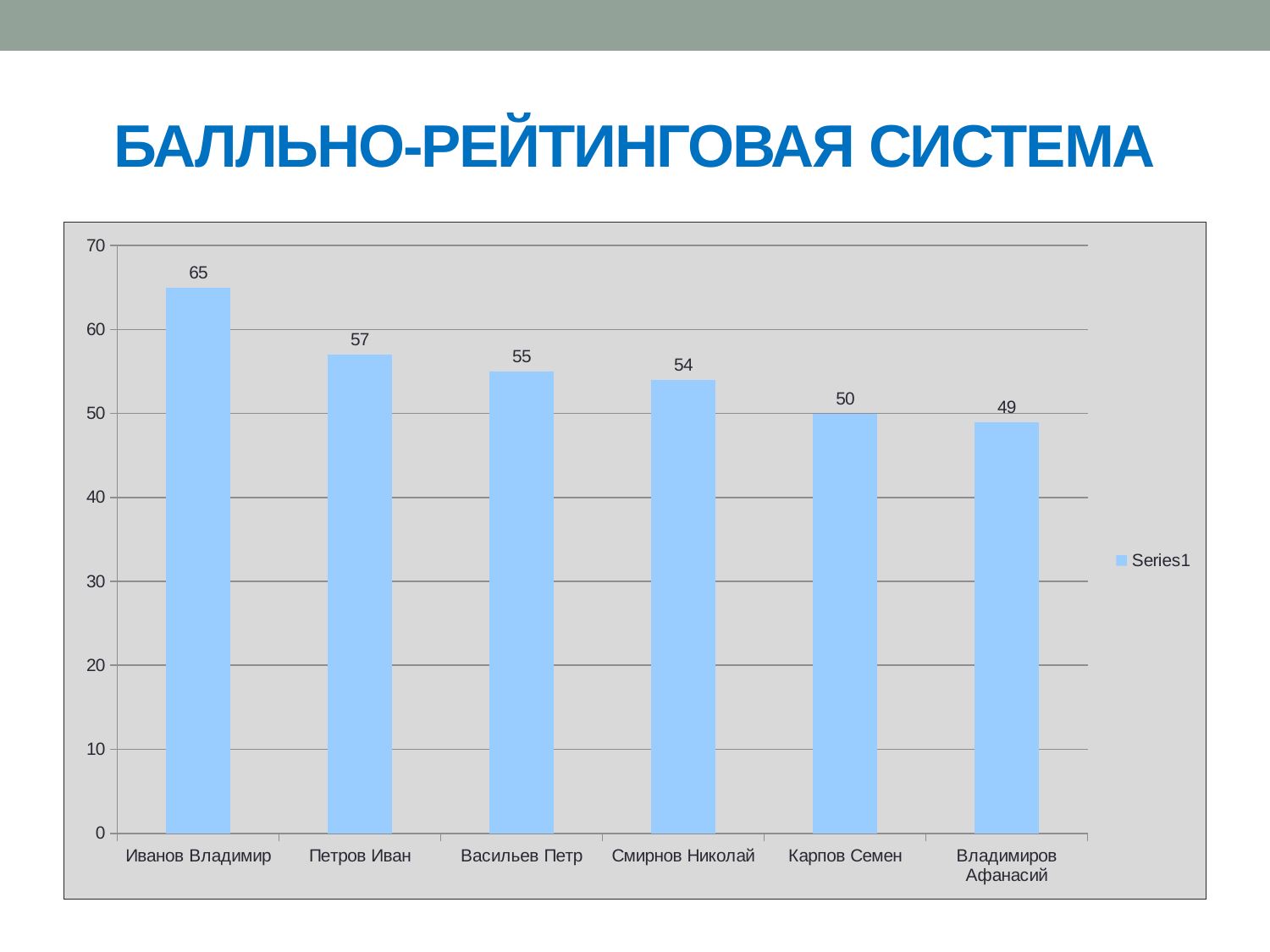
What is the difference between the values for Иванов Владимир and Петров Иван? 8 What is the value for Владимиров Афанасий? 49 Which category has the lowest value? Владимиров Афанасий How many categories are shown on the x axis? 6 What is the value for Карпов Семен? 50 What kind of chart is shown on the slide? bar chart Which category has the highest value? Иванов Владимир Which is larger, the value for Петров Иван or the value for Смирнов Николай? Петров Иван How many series does the legend list? 1 What is the difference between the values for Васильев Петр and Владимиров Афанасий? 6 What is the value for Иванов Владимир? 65 Do the values rise or fall from left to right along the x axis? fall